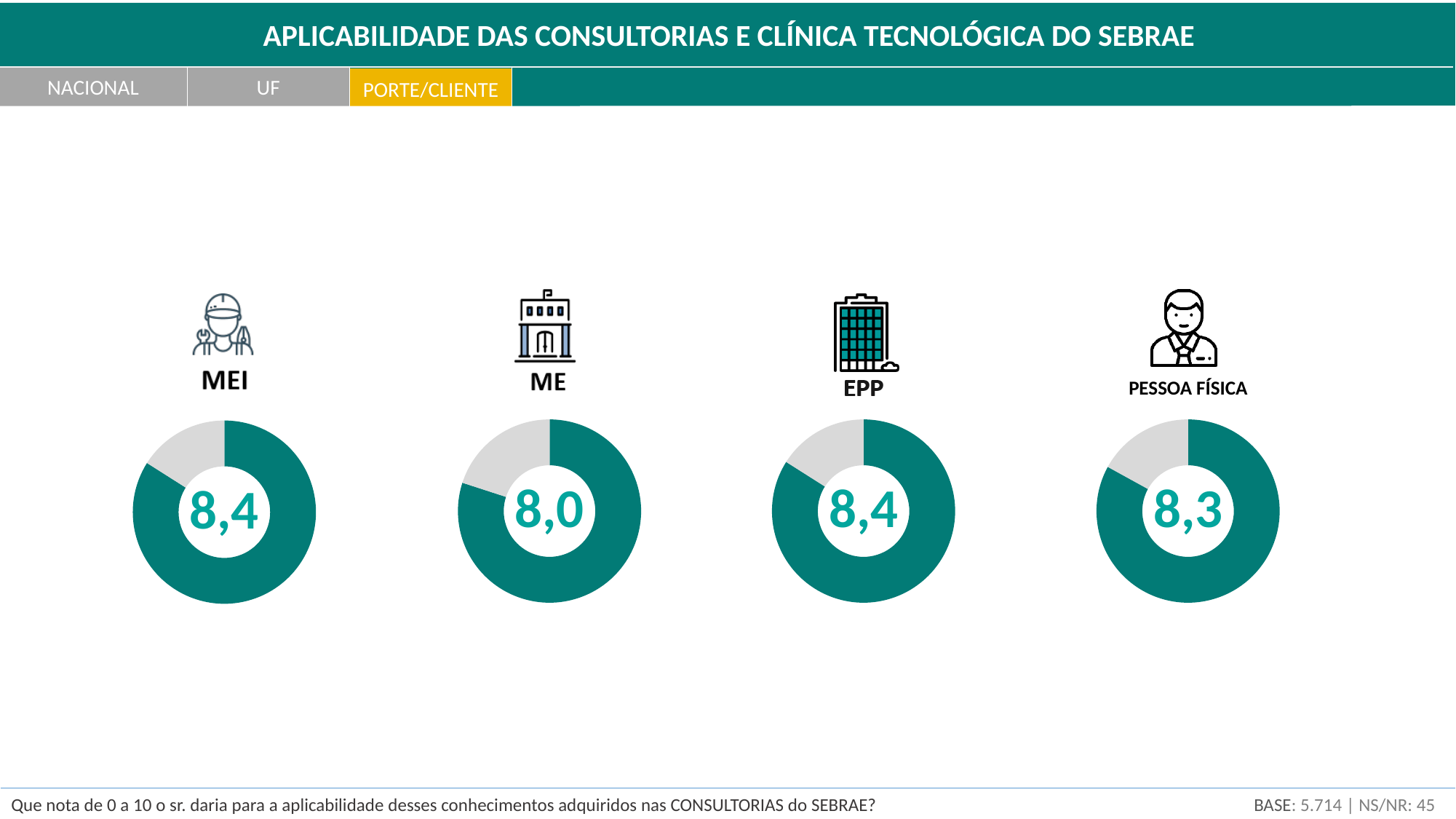
What score is shown in the EPP donut chart? 8,4 Which has a higher score, ME or PESSOA FÍSICA? PESSOA FÍSICA What kind of chart is used to display the scores on this slide? Donut (pie) chart What score is shown in the PESSOA FÍSICA donut chart? 8,3 What is the difference between the MEI score and the ME score? 0,4 Which category has the lowest score among the four donut charts? ME What score is shown in the ME donut chart? 8,0 How many donut charts are shown on the slide? 4 What score is shown in the MEI donut chart? 8,4 What is the highest score shown across the four donut charts? 8,4 What is the title of the slide? APLICABILIDADE DAS CONSULTORIAS E CLÍNICA TECNOLÓGICA DO SEBRAE Which tab is highlighted in yellow at the top of the slide? PORTE/CLIENTE